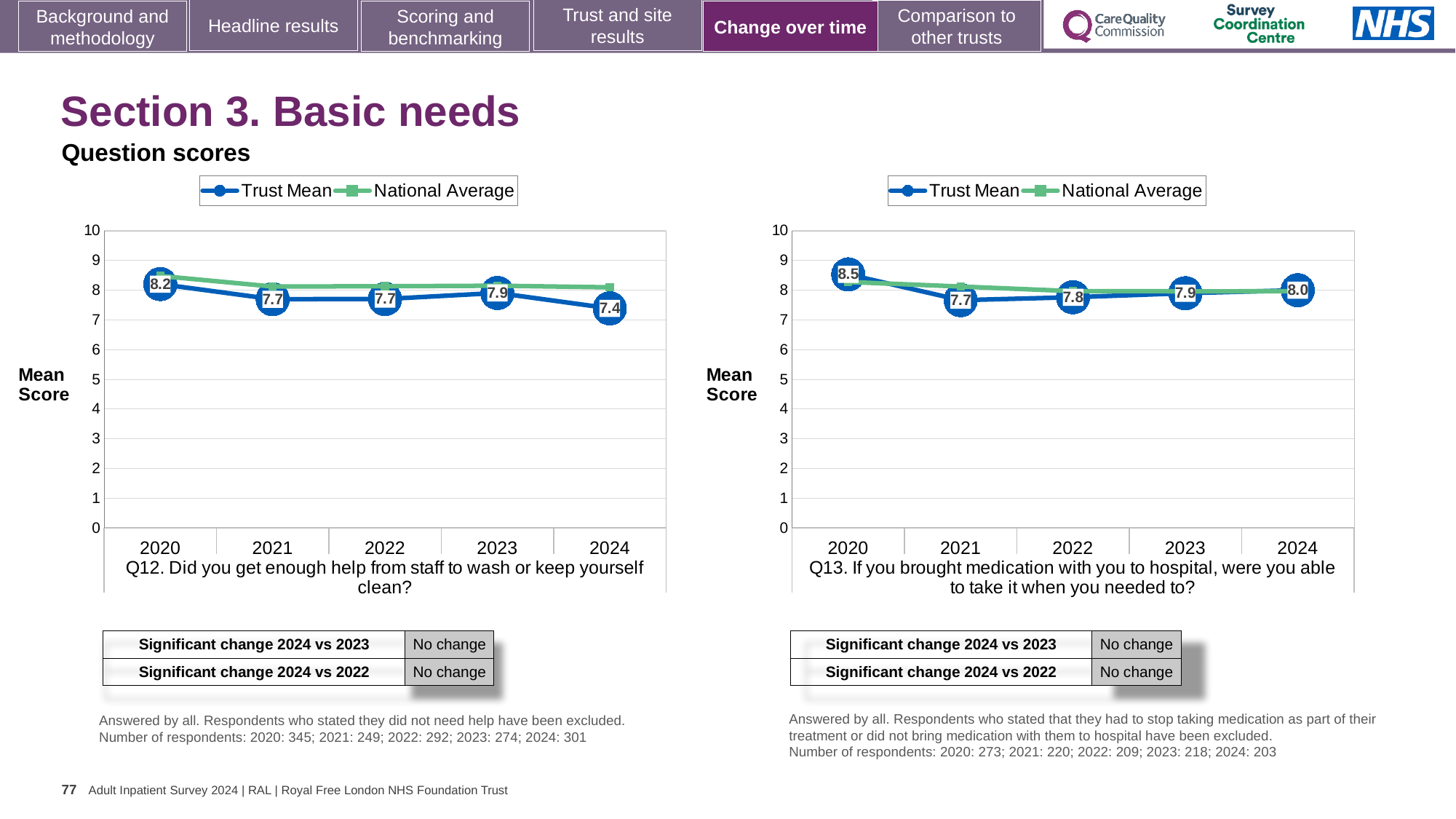
On the Q13 chart (right), which year has the highest Trust Mean? 2020 How many series does the legend of the Q13 chart (right) list? 2 Is the Trust Mean for 2024 higher on the Q12 chart (left) or the Q13 chart (right)? Q13 chart (right) On the Q13 chart (right), what is the Trust Mean for 2024? 8.0 On the Q13 chart (right), what is the difference between the Trust Mean in 2020 and in 2021? 0.8 On the Q12 chart (left), what is the Trust Mean for 2020? 8.2 On the Q13 chart (right), is the National Average for 2020 greater or less than 7? greater On the Q12 chart (left), which year has the lowest Trust Mean? 2024 On the Q13 chart (right), what is the Trust Mean for 2020? 8.5 How many years are plotted on the Q12 chart (left)? 5 On the Q12 chart (left), what is the Trust Mean for 2024? 7.4 On the Q12 chart (left), what is the difference between the Trust Mean in 2020 and in 2024? 0.8